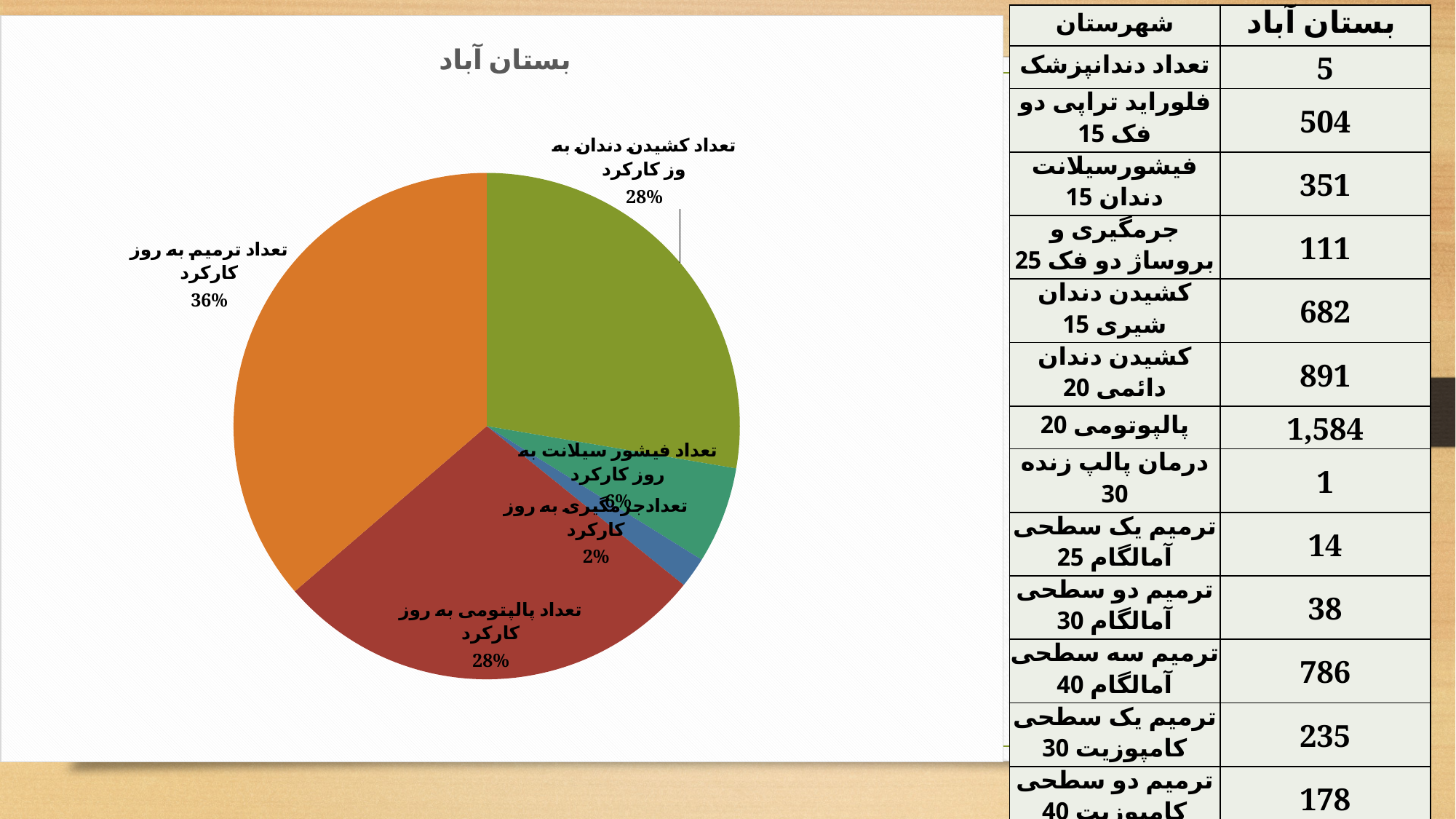
What is the title of the pie chart? بستان آباد Which slice of the pie chart is the largest? تعداد ترمیم به روز کارکرد What colour is the slice for تعداد پالپوتومی به روز کارکرد? red What share of the pie does تعداد فیشور سیلانت به روز کارکرد have? 6% What kind of chart is shown on the slide? pie chart What is the difference in percentage points between the share for تعداد ترمیم به روز کارکرد and the share for تعداد فیشور سیلانت به روز کارکرد? 30% What share of the pie does تعداد ترمیم به روز کارکرد have? 36% What share of the pie does تعداد جرمگیری به روز کارکرد have? 2% Which is larger: the share for تعداد ترمیم به روز کارکرد or the share for تعداد کشیدن دندان به روز کارکرد? تعداد ترمیم به روز کارکرد How many slices does the pie chart have? 5 Which slice of the pie chart is the smallest? تعداد جرمگیری به روز کارکرد